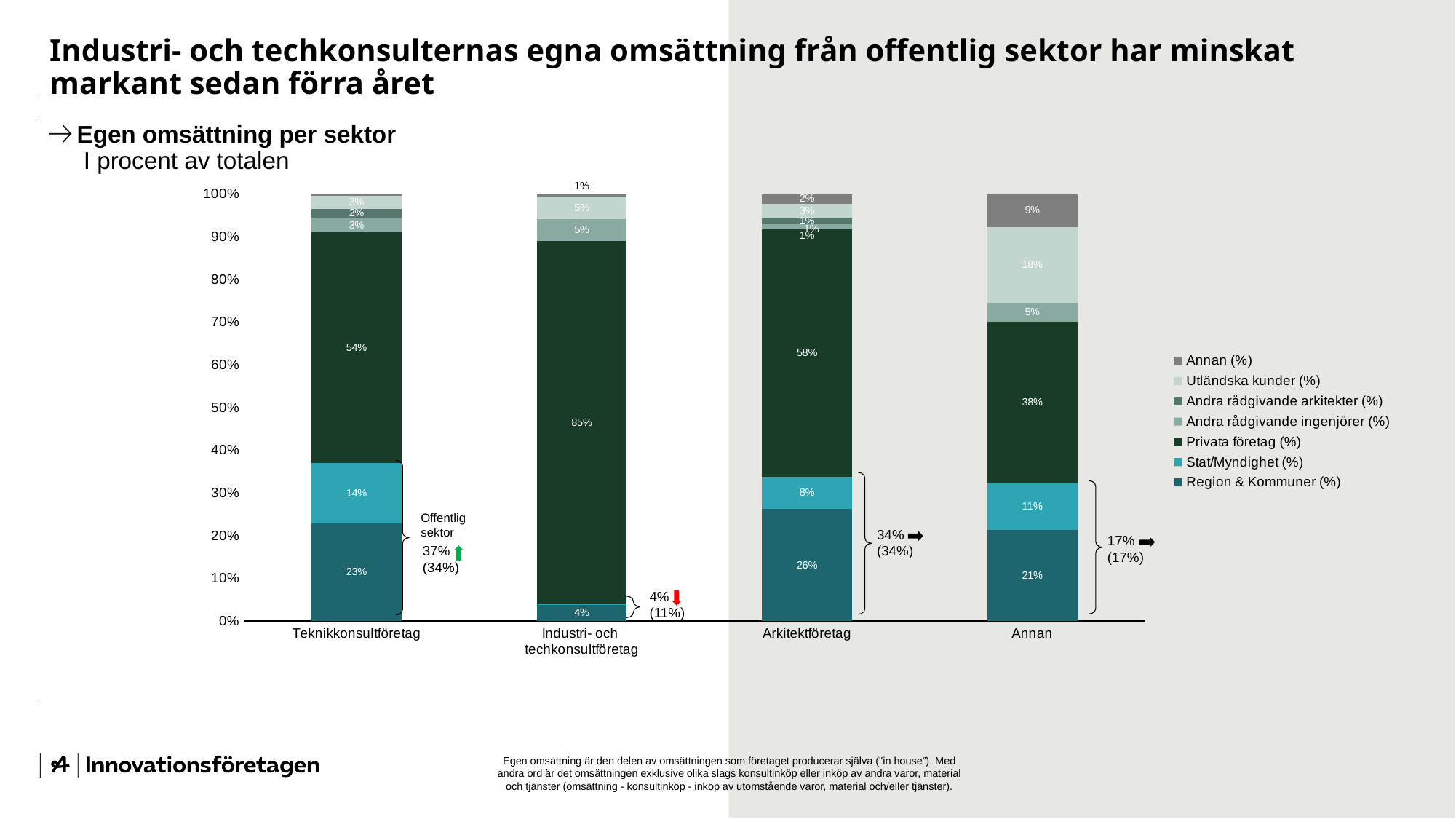
What is the value of Privata företag (%) for Industri- och techkonsultföretag? 85% Which is larger: Stat/Myndighet (%) for Teknikkonsultföretag or for Arkitektföretag? Teknikkonsultföretag Which category has the lowest value for Region & Kommuner (%)? Industri- och techkonsultföretag What is the difference between the Privata företag (%) values for Arkitektföretag and Teknikkonsultföretag? 4 percentage points What kind of chart is shown on the slide? Stacked bar chart How many series does the legend list? 7 How many categories are shown on the x axis? 4 Which category has the highest value for Privata företag (%)? Industri- och techkonsultföretag What is the value of Stat/Myndighet (%) for Teknikkonsultföretag? 14% What share of Teknikkonsultföretag's own revenue comes from Offentlig sektor according to the annotation? 37% What is the value of Region & Kommuner (%) for Arkitektföretag? 26% What is the value of Utländska kunder (%) for the Annan category? 18%